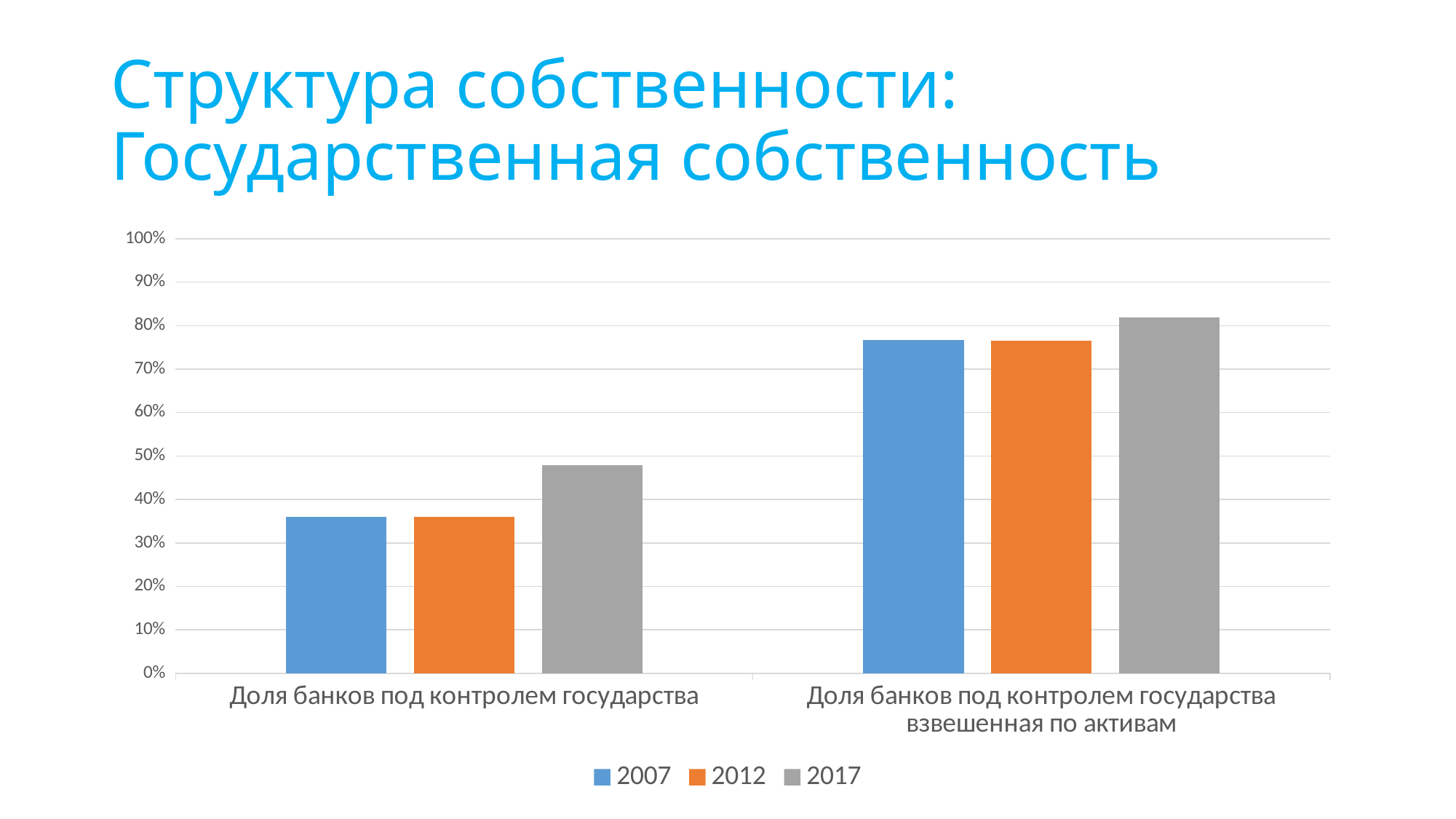
Which year has the highest value in the category "Доля банков под контролем государства"? 2017 Which years are listed in the legend? 2007, 2012, 2017 Which is larger: the 2017 value for "Доля банков под контролем государства" or the 2017 value for "Доля банков под контролем государства взвешенная по активам"? Доля банков под контролем государства взвешенная по активам Is the value for 2007 in the category "Доля банков под контролем государства" greater or less than 40%? less Which year has the highest value in the category "Доля банков под контролем государства взвешенная по активам"? 2017 Is the value for 2017 in the category "Доля банков под контролем государства" greater or less than 40%? greater How many categories are shown on the x axis? 2 How many series does the legend list? 3 Is the value for 2012 in the category "Доля банков под контролем государства взвешенная по активам" greater or less than 80%? less What is the title of the slide? Структура собственности: Государственная собственность What kind of chart is shown on the slide? bar chart